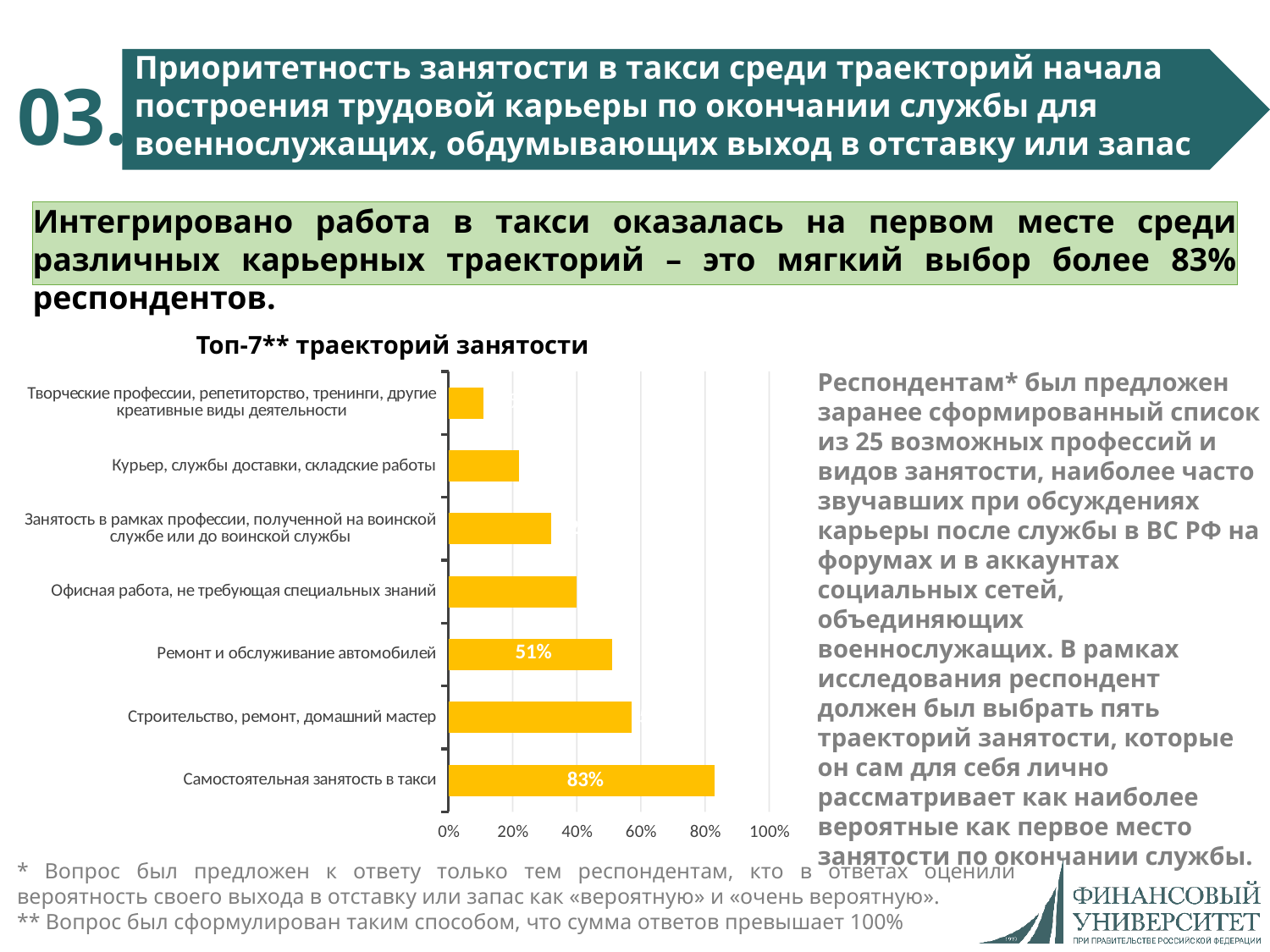
Which category has the highest value? Самостоятельная занятость в такси What is the title of the chart? Топ-7** траекторий занятости Is the value for "Строительство, ремонт, домашний мастер" greater or less than 40%? greater How many categories are shown in the chart? 7 What is the value for "Самостоятельная занятость в такси"? 83% What is the difference between the values for "Самостоятельная занятость в такси" and "Ремонт и обслуживание автомобилей"? 32% Is the value for "Занятость в рамках профессии, полученной на воинской службе или до воинской службы" greater or less than 40%? less What type of chart is shown on the slide? bar chart Is the value for "Творческие профессии, репетиторство, тренинги, другие креативные виды деятельности" greater or less than 20%? less Which category has the lowest value? Творческие профессии, репетиторство, тренинги, другие креативные виды деятельности What is the value for "Ремонт и обслуживание автомобилей"? 51% Which is larger: the value for "Офисная работа, не требующая специальных знаний" or for "Курьер, службы доставки, складские работы"? Офисная работа, не требующая специальных знаний